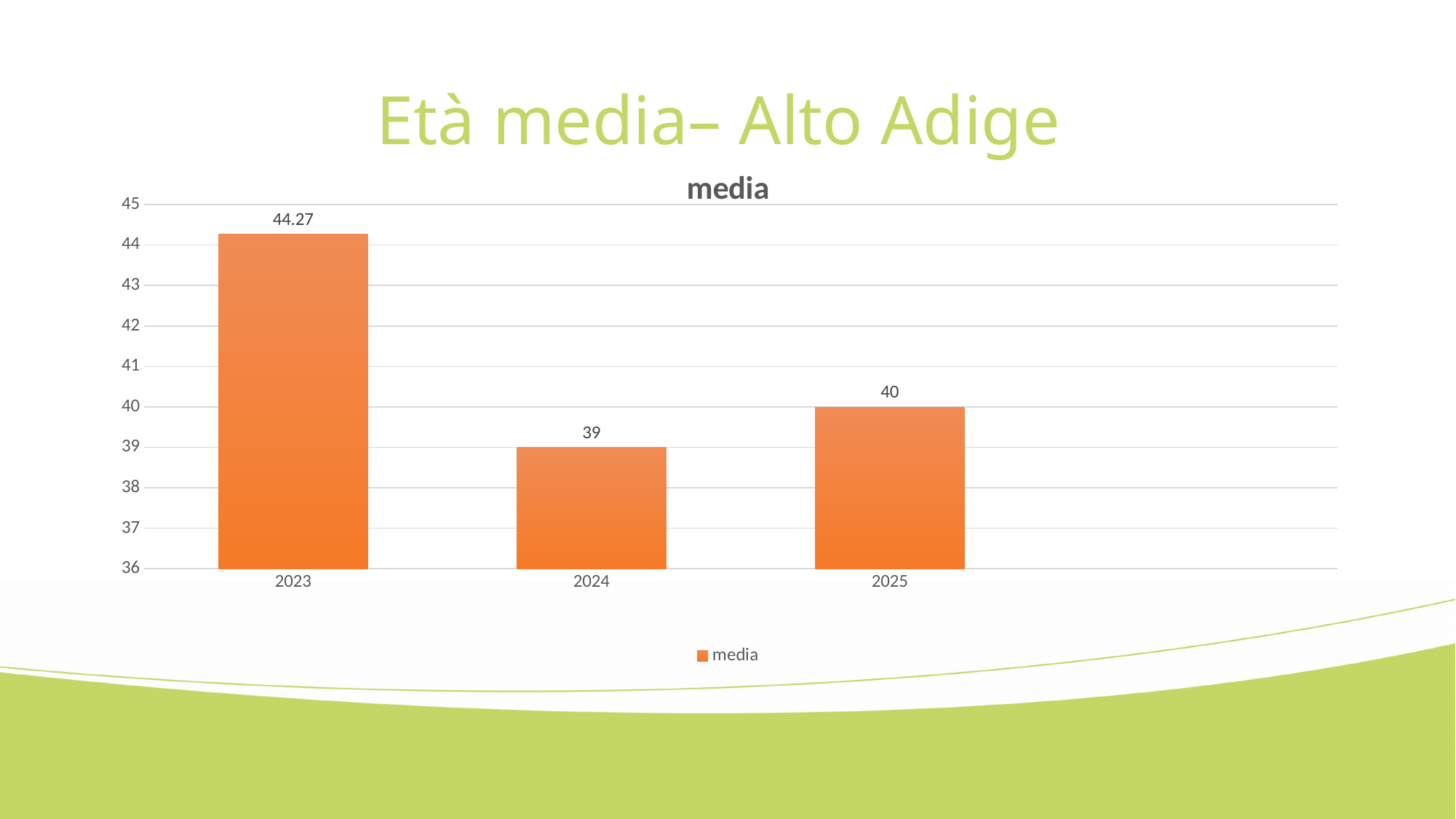
What is the title of the chart? media Which year has the lowest value? 2024 How many years are shown on the x axis? 3 What is the value for 2025? 40 Which year has the highest value? 2023 What is the difference between the values for 2023 and 2024? 5.27 Which is larger, the value for 2024 or the value for 2025? 2025 What is the difference between the values for 2025 and 2024? 1 What kind of chart is shown? bar chart What is the value for 2024? 39 Is the value for 2023 greater or less than 44? greater What is the value for 2023? 44.27